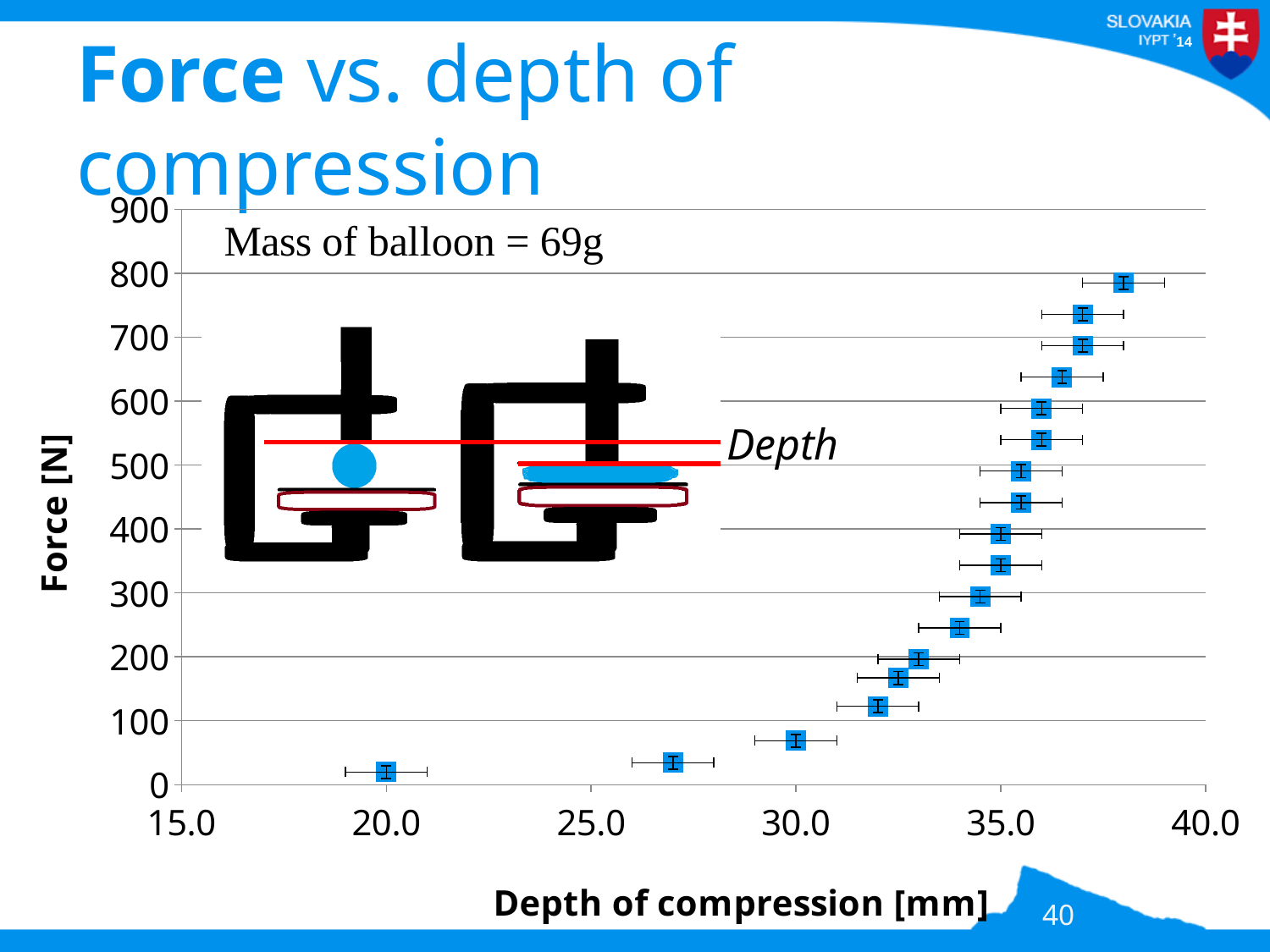
Is the depth of compression for the point with the highest force greater or less than 35.0 mm? greater What kind of chart is shown on the slide? scatter chart Is the highest force plotted on the chart greater or less than 800 N? less Is the force at a depth of compression of 30.0 mm greater or less than 100 N? less What mass of balloon is stated on the chart? 69g As depth of compression increases along the x axis, does the force rise or fall? rise Which has the larger force: the point at a depth of 20.0 mm or the point at a depth of 30.0 mm? 30.0 mm What is the label of the y axis? Force [N]